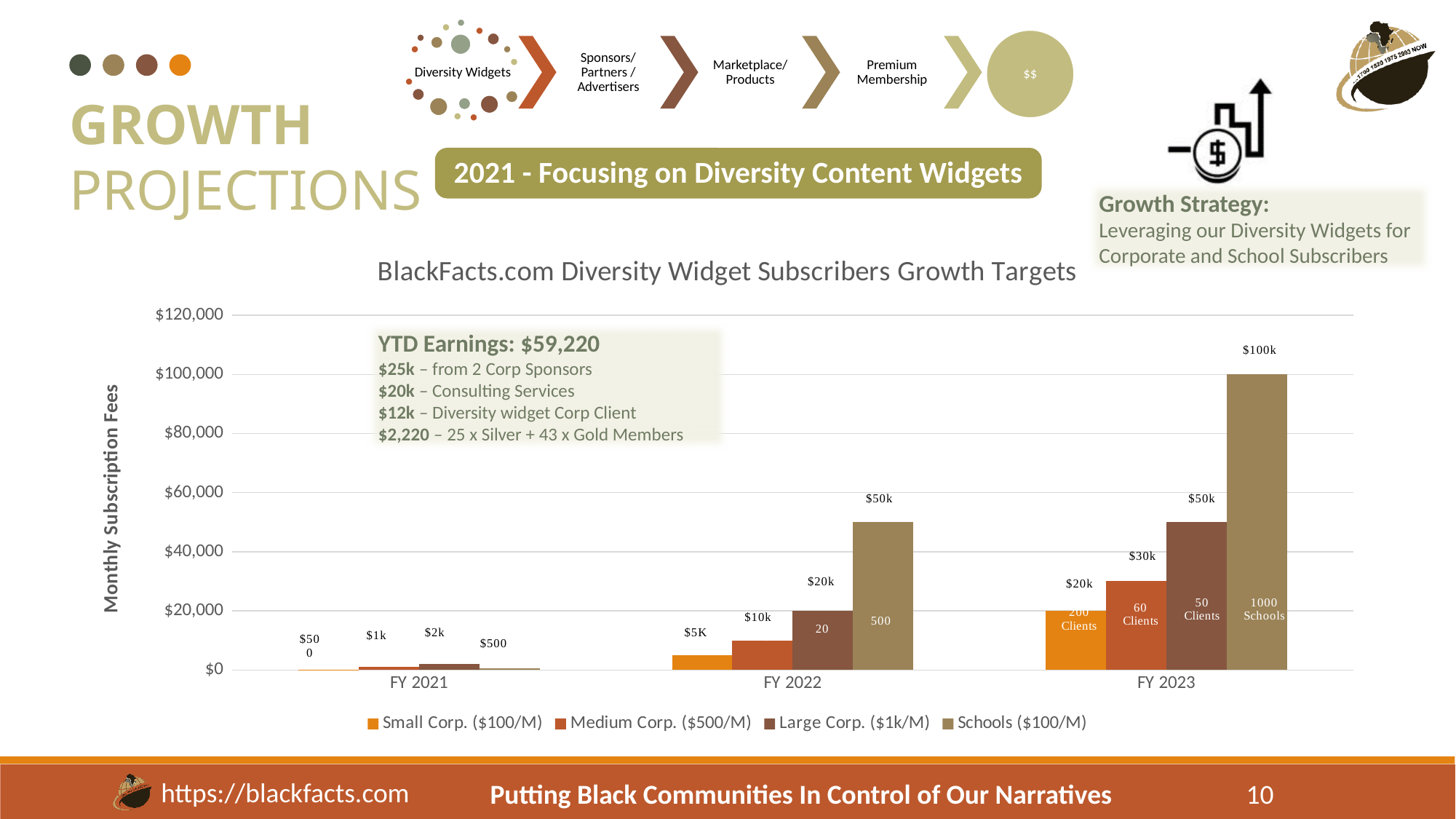
How many fiscal year categories are shown on the x axis? 3 What is the value for Schools ($100/M) in FY 2023? $100k What is the value for Large Corp. ($1k/M) in FY 2022? $20k Which series has the highest value in FY 2023? Schools ($100/M) What is the value for Small Corp. ($100/M) in FY 2022? $5K Which series has the lowest value in FY 2022? Small Corp. ($100/M) Do the Schools ($100/M) values rise or fall from FY 2021 to FY 2023? rise Which is larger in FY 2023: Large Corp. ($1k/M) or Medium Corp. ($500/M)? Large Corp. ($1k/M) How many series does the chart legend list? 4 What is the value for Medium Corp. ($500/M) in FY 2023? $30k What is the title of the chart? BlackFacts.com Diversity Widget Subscribers Growth Targets What type of chart is shown on the slide? bar chart